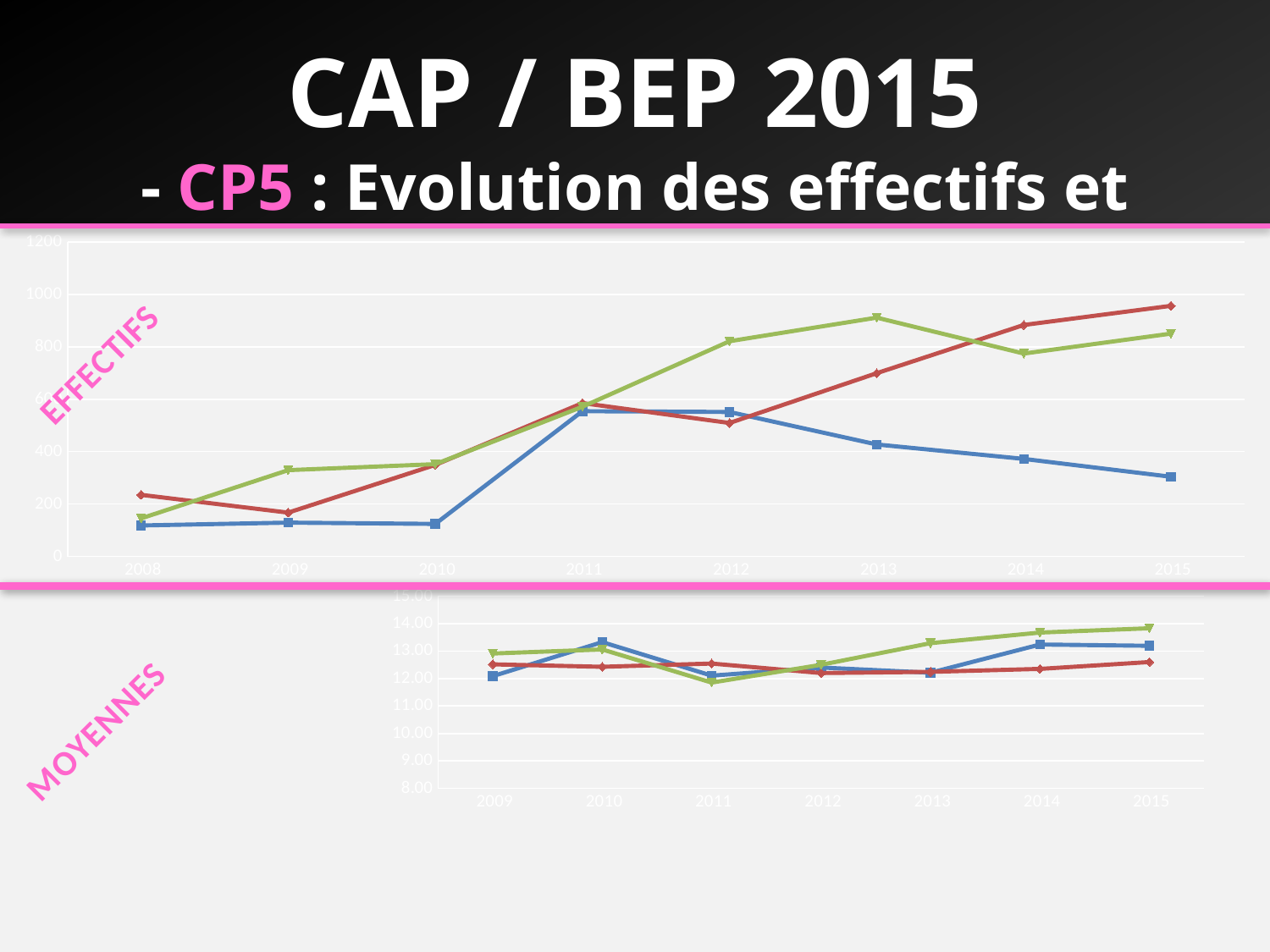
In the top chart (EFFECTIFS), is the value of the blue line in 2015 greater or less than 400? less What kind of chart is the top chart labelled EFFECTIFS? line chart In the top chart (EFFECTIFS), which line has the highest value in 2015: red, green or blue? red In the top chart (EFFECTIFS), does the blue line rise or fall between 2012 and 2015? fall In the top chart (EFFECTIFS), how many years are shown on the x axis? 8 What kind of chart is the bottom chart labelled MOYENNES? line chart In the bottom chart (MOYENNES), how many years are shown on the x axis? 7 What is the pink label written beside the top chart? EFFECTIFS In the top chart (EFFECTIFS), is the value of the blue line in 2008 greater or less than 200? less In the bottom chart (MOYENNES), is the value of the green line in 2015 greater or less than 13.00? greater In the top chart (EFFECTIFS), how many lines are plotted? 3